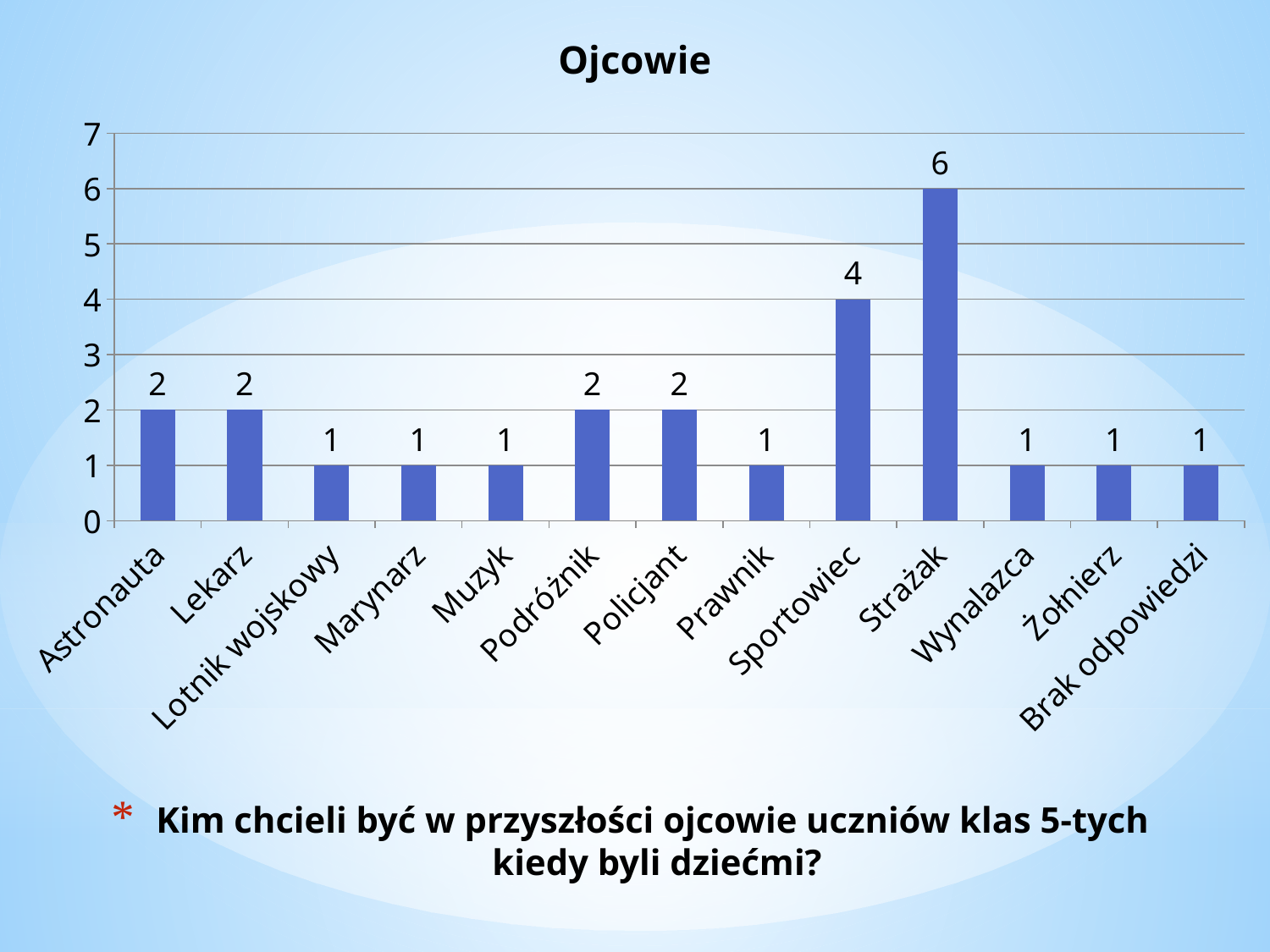
Which is larger, the value for Astronauta or the value for Marynarz? Astronauta What is the value for Sportowiec? 4 What is the difference between the values for Strażak and Sportowiec? 2 What is the value for Lekarz? 2 What kind of chart is shown on the slide? bar chart How many categories are shown on the x axis? 13 What is the value for Brak odpowiedzi? 1 What is the difference between the values for Sportowiec and Policjant? 2 What is the value for Strażak? 6 Which category has the highest value? Strażak What is the title of the chart? Ojcowie Is the value for Strażak greater or less than 5? greater